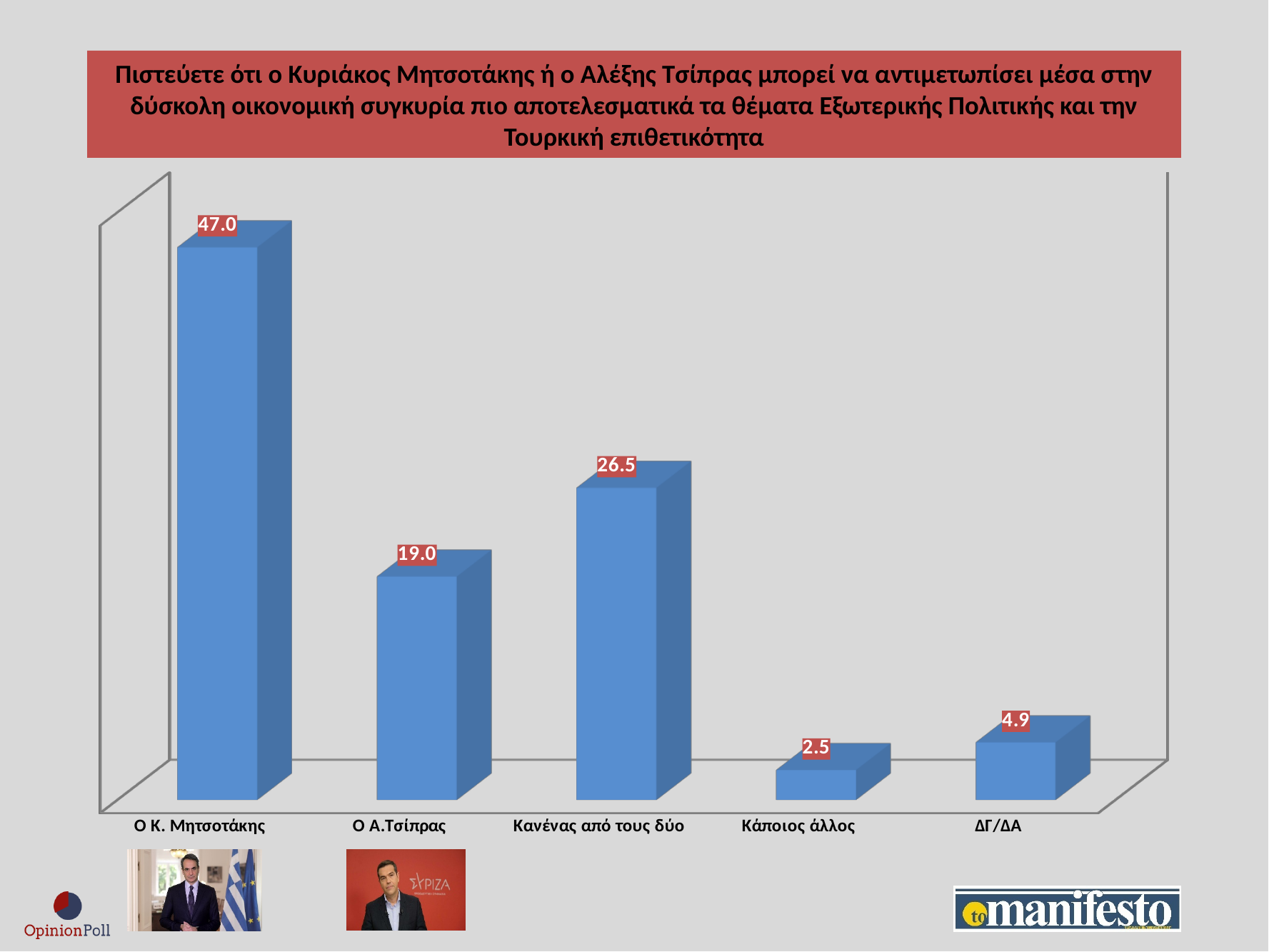
What is the value for ΔΓ/ΔΑ? 4.9 What is the value for Ο Κ. Μητσοτάκης? 47.0 Which category has the lowest value? Κάποιος άλλος What is the value for Ο Α.Τσίπρας? 19.0 What is the value for Κάποιος άλλος? 2.5 What is the value for Κανένας από τους δύο? 26.5 What is the difference between the values for Ο Κ. Μητσοτάκης and Ο Α.Τσίπρας? 28.0 How many categories are shown in the chart? 5 What kind of chart is shown on the slide? Bar chart Which is larger, the value for Ο Α.Τσίπρας or the value for Κανένας από τους δύο? Κανένας από τους δύο Which category has the highest value? Ο Κ. Μητσοτάκης What is the difference between the values for ΔΓ/ΔΑ and Κάποιος άλλος? 2.4